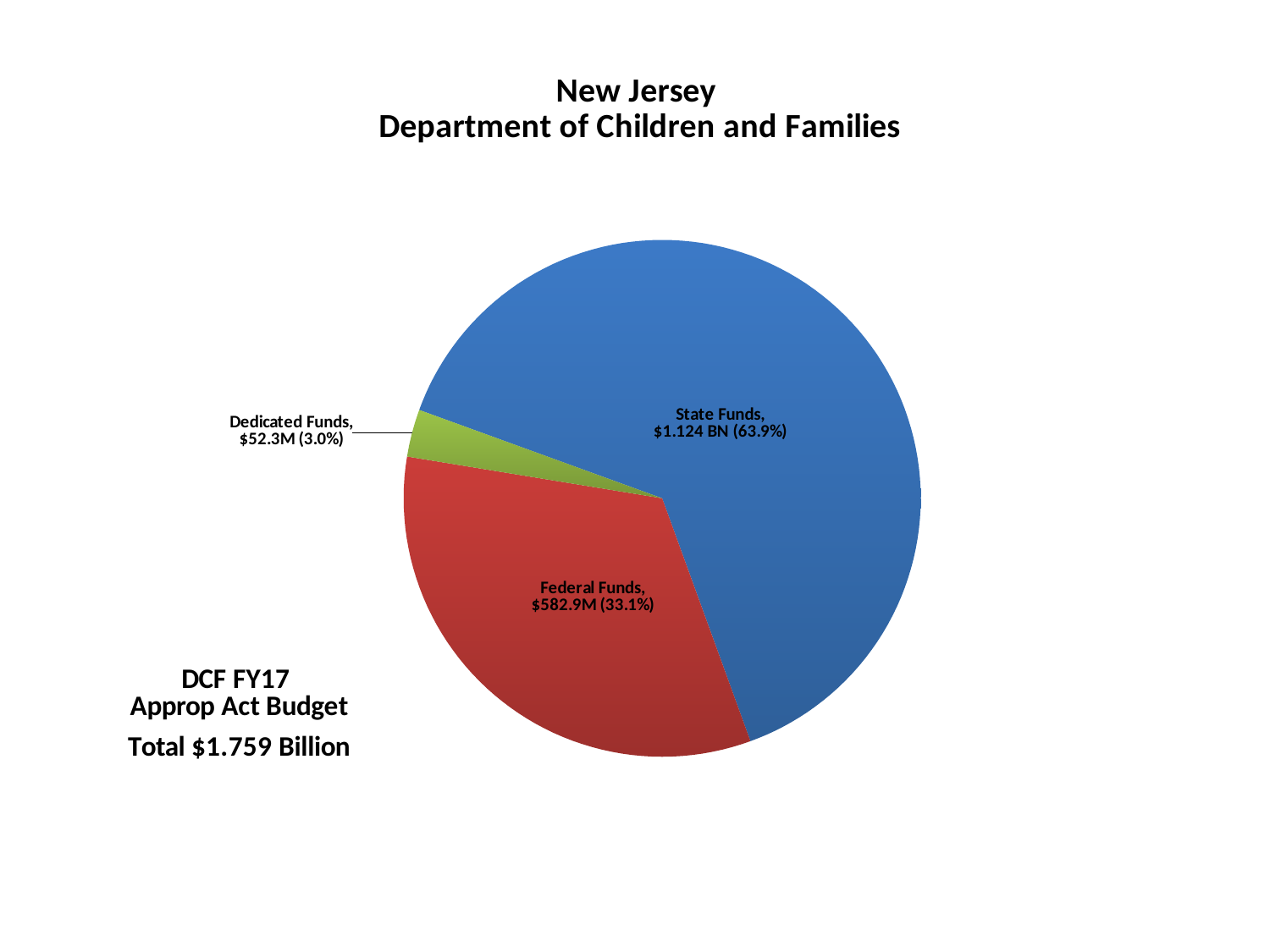
What share of the pie is Dedicated Funds? 3.0% Which slice is the largest? State Funds What total budget is stated on the slide? $1.759 Billion What is the value shown for Dedicated Funds? $52.3M What is the value shown for Federal Funds? $582.9M What share of the pie is State Funds? 63.9% What share of the pie is Federal Funds? 33.1% Which is larger, Federal Funds or Dedicated Funds? Federal Funds How many slices does the pie chart have? 3 Which slice is the smallest? Dedicated Funds What kind of chart is shown on the slide? pie chart What is the value shown for State Funds? $1.124 BN